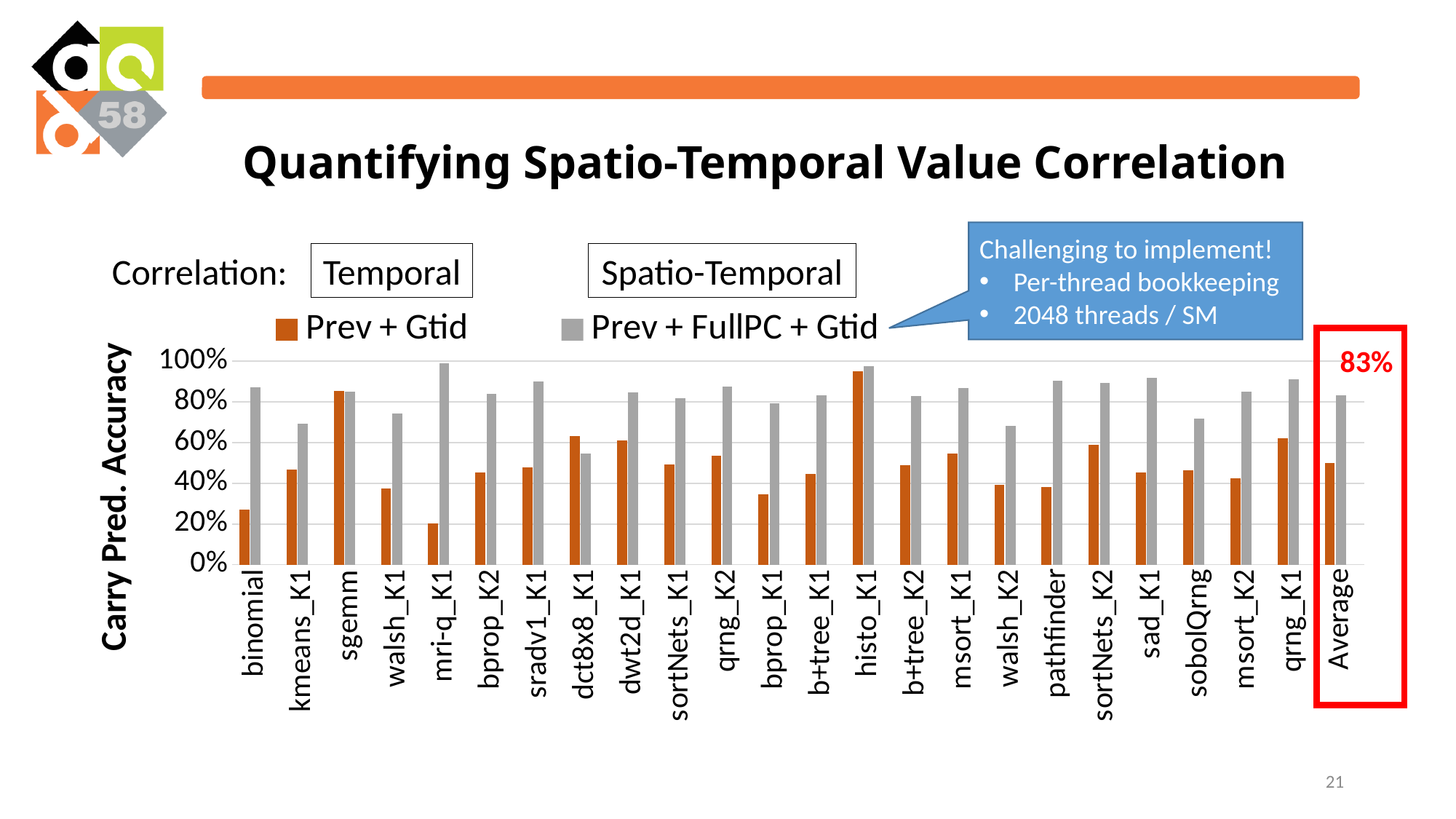
Which category has the highest value for the Prev + Gtid series? histo_K1 What kind of chart is shown on the slide? bar chart Is the Prev + FullPC + Gtid value for mri-q_K1 greater or less than 80%? greater For dct8x8_K1, which series has the larger value, Prev + Gtid or Prev + FullPC + Gtid? Prev + Gtid For binomial, which series has the larger value, Prev + Gtid or Prev + FullPC + Gtid? Prev + FullPC + Gtid What is the label on the y axis of the chart? Carry Pred. Accuracy How many series does the legend list? 2 Is the Prev + Gtid value for mri-q_K1 greater or less than 40%? less Which category has the lowest value for the Prev + FullPC + Gtid series? dct8x8_K1 How many categories are shown along the x axis, including Average? 24 Which category has the lowest value for the Prev + Gtid series? mri-q_K1 What is the Average value for the Prev + FullPC + Gtid series? 83%